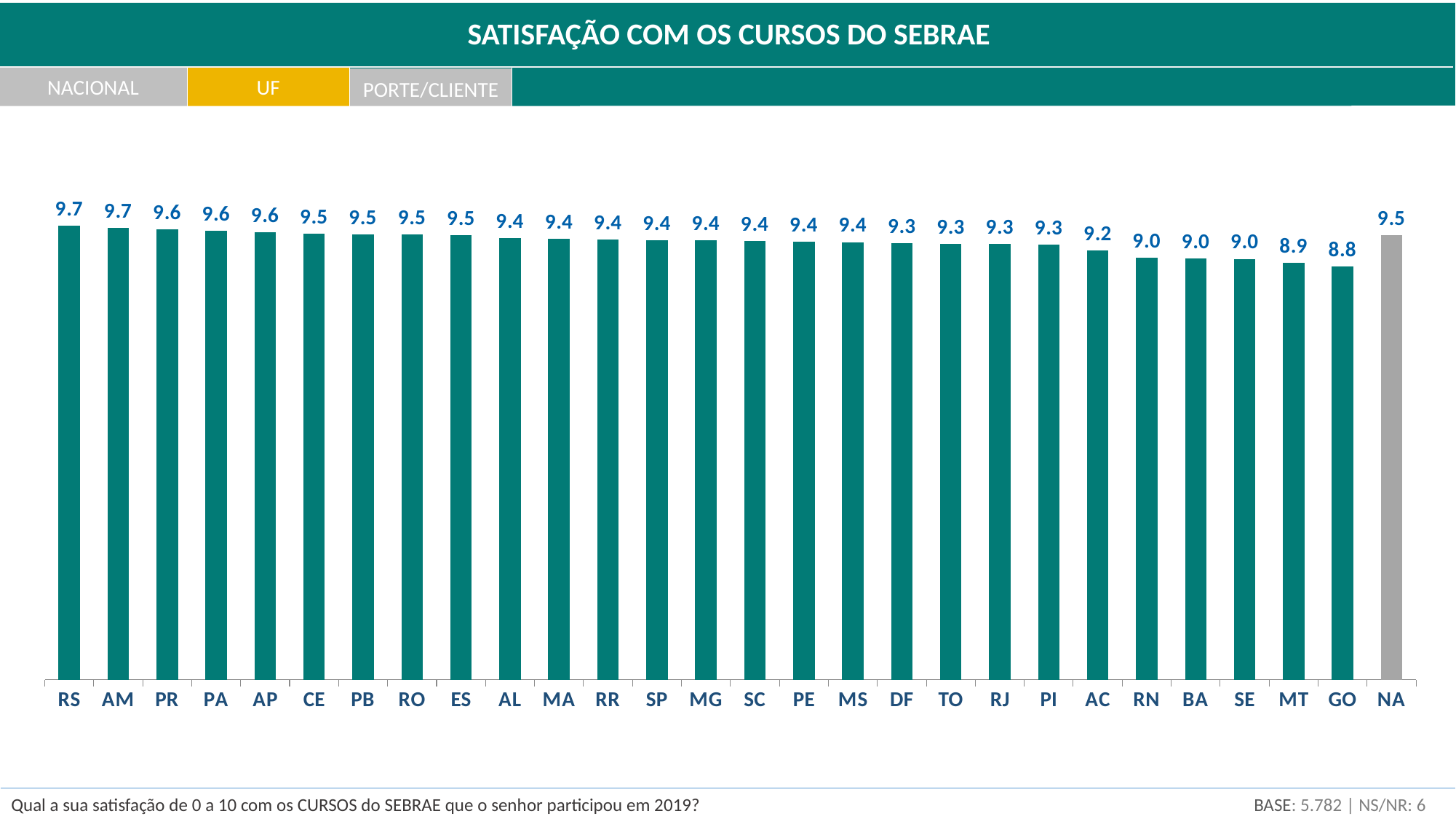
Which has a higher value, PR or RN? PR What is the difference between the values for NA and MT? 0.6 Which has a higher value, GO or SE? SE How many bars are shown in the chart? 28 What is the satisfaction value for RS? 9.7 What kind of chart is shown on the slide? Bar chart Do the values for the states (from RS to GO) rise or fall from left to right? Fall What is the difference between the values for RS and GO? 0.9 What is the satisfaction value for AC? 9.2 What is the value shown for NA (the grey bar)? 9.5 Which category has the lowest satisfaction value? GO What is the satisfaction value for GO? 8.8